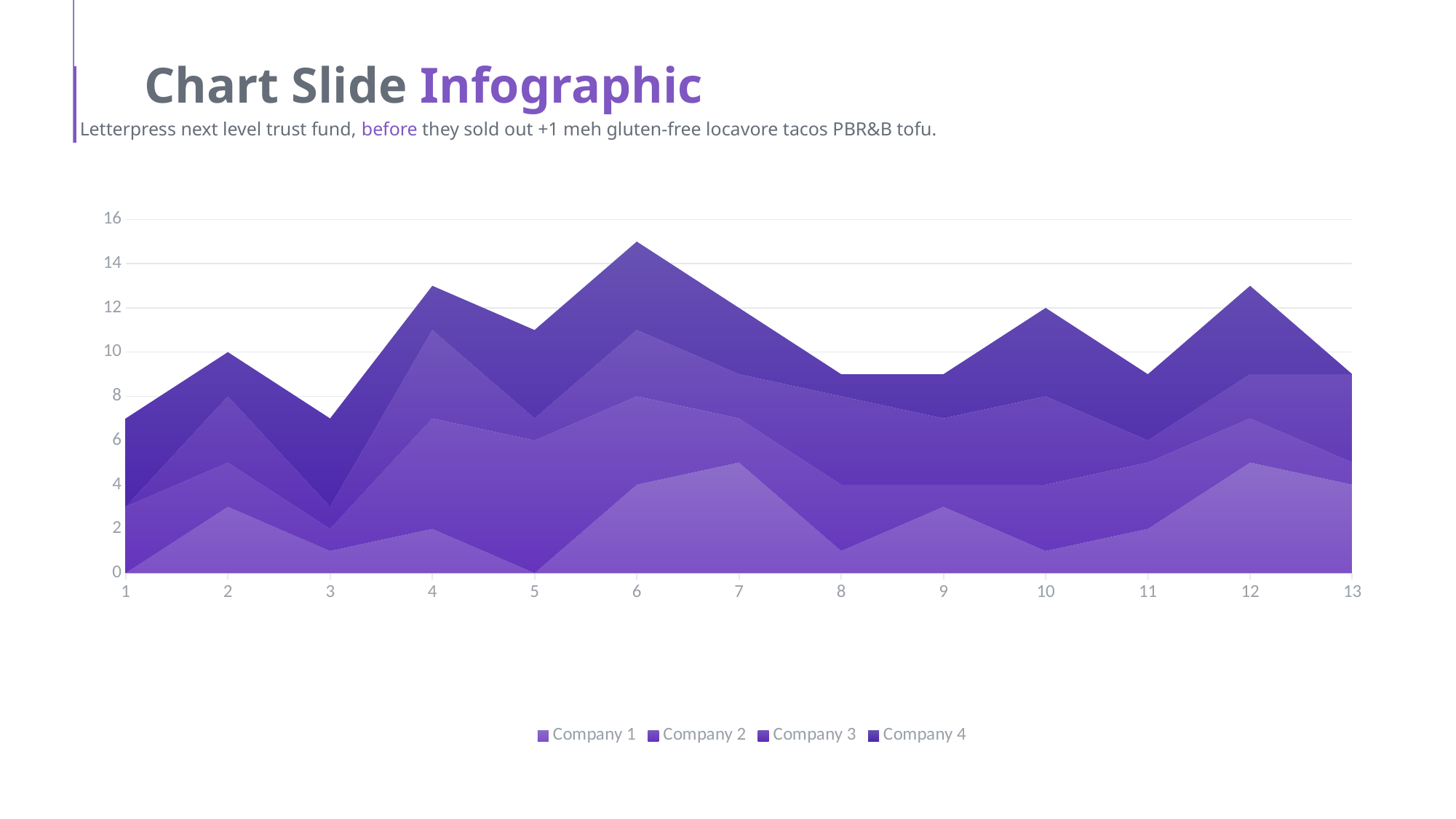
Is the top of the stacked area at point 6 greater or less than 14? greater Which is larger, the top of the stacked area at point 6 or at point 8? Point 6 Is the value for Company 1 at point 1 greater or less than 2? less At which x-axis point does the top of the stacked area reach its highest value? 6 What are the names of the series listed in the legend? Company 1, Company 2, Company 3, Company 4 What is the title of the slide containing the chart? Chart Slide Infographic Is the value for Company 1 at point 7 greater or less than 4? greater How many series does the legend list? 4 What kind of chart is shown on the slide? Area chart How many points are plotted along the x axis? 13